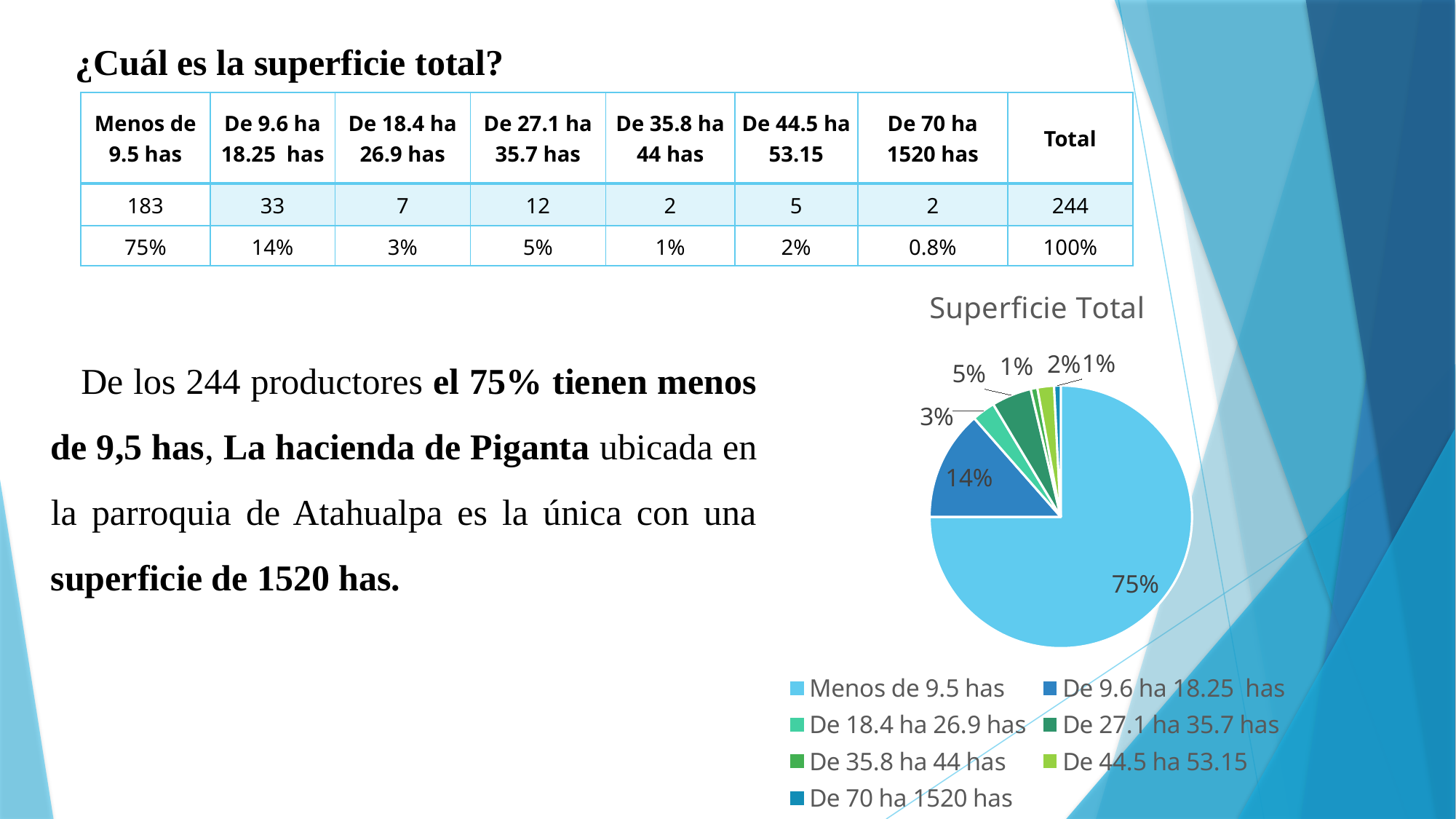
What is the title of the chart? Superficie Total What colour is the slice for 'Menos de 9.5 has'? light blue What share of the pie does 'Menos de 9.5 has' represent? 75% Which category has the largest slice in the pie chart? Menos de 9.5 has Which slice is larger, 'De 27.1 ha 35.7 has' or 'De 18.4 ha 26.9 has'? De 27.1 ha 35.7 has What is the difference in percentage points between the 'Menos de 9.5 has' slice and the 'De 9.6 ha 18.25 has' slice? 61 What kind of chart is shown on the slide? pie chart What percentage is shown for 'De 9.6 ha 18.25 has' in the pie chart? 14% How many slices does the pie chart have? 7 What percentage is shown for 'De 18.4 ha 26.9 has' in the pie chart? 3% What percentage is shown for 'De 27.1 ha 35.7 has' in the pie chart? 5% How many entries does the chart legend list? 7